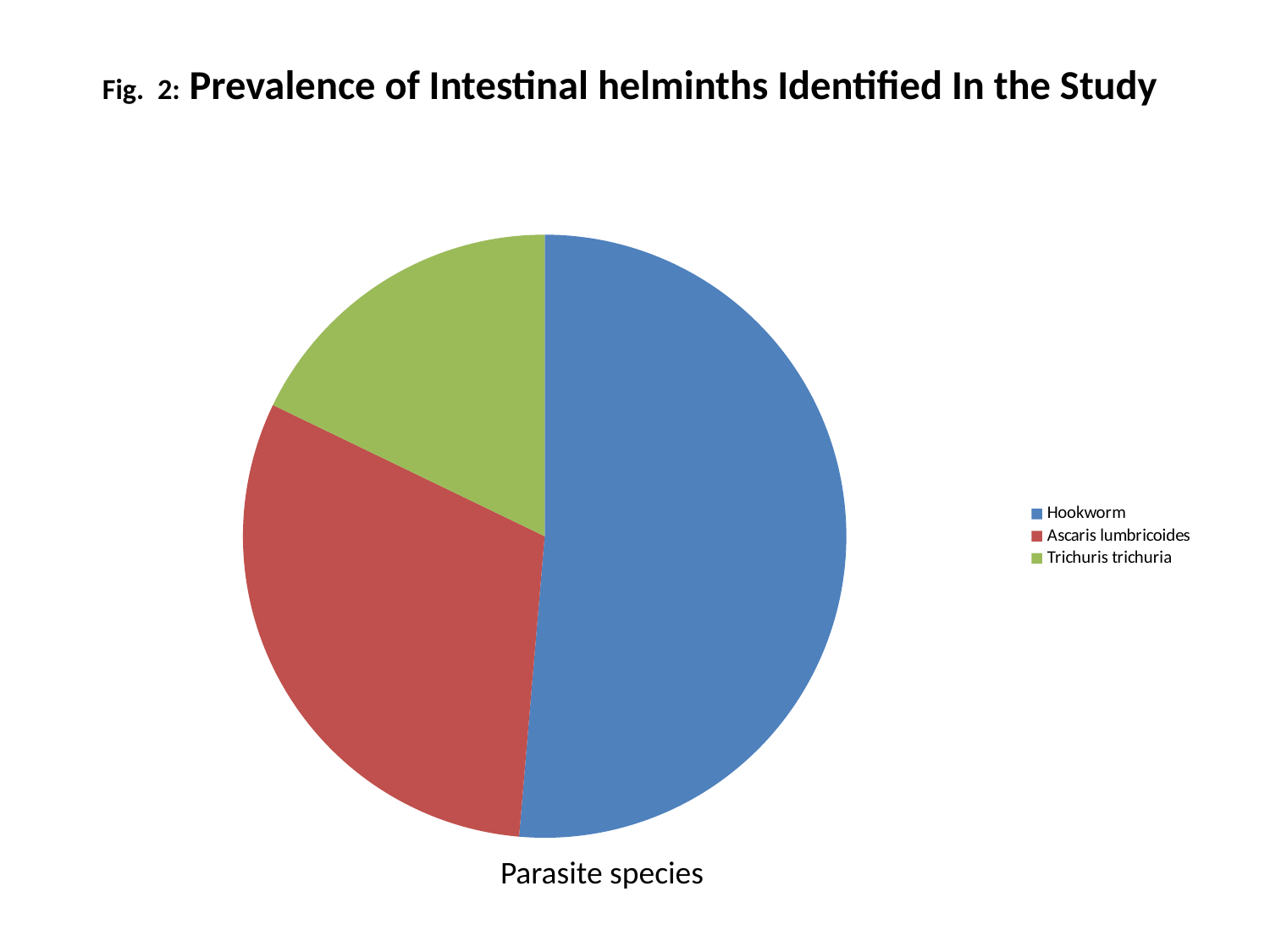
How many entries does the legend list? 3 Which has the larger slice, Ascaris lumbricoides or Trichuris trichuria? Ascaris lumbricoides Which has the larger slice, Hookworm or Ascaris lumbricoides? Hookworm What is the title of the chart? Fig. 2: Prevalence of Intestinal helminths Identified In the Study Which parasite species is shown in blue? Hookworm What kind of chart is shown on the slide? Pie chart How many parasite species are shown in the pie chart? 3 Which parasite species has the largest slice of the pie? Hookworm Which parasite species has the smallest slice of the pie? Trichuris trichuria